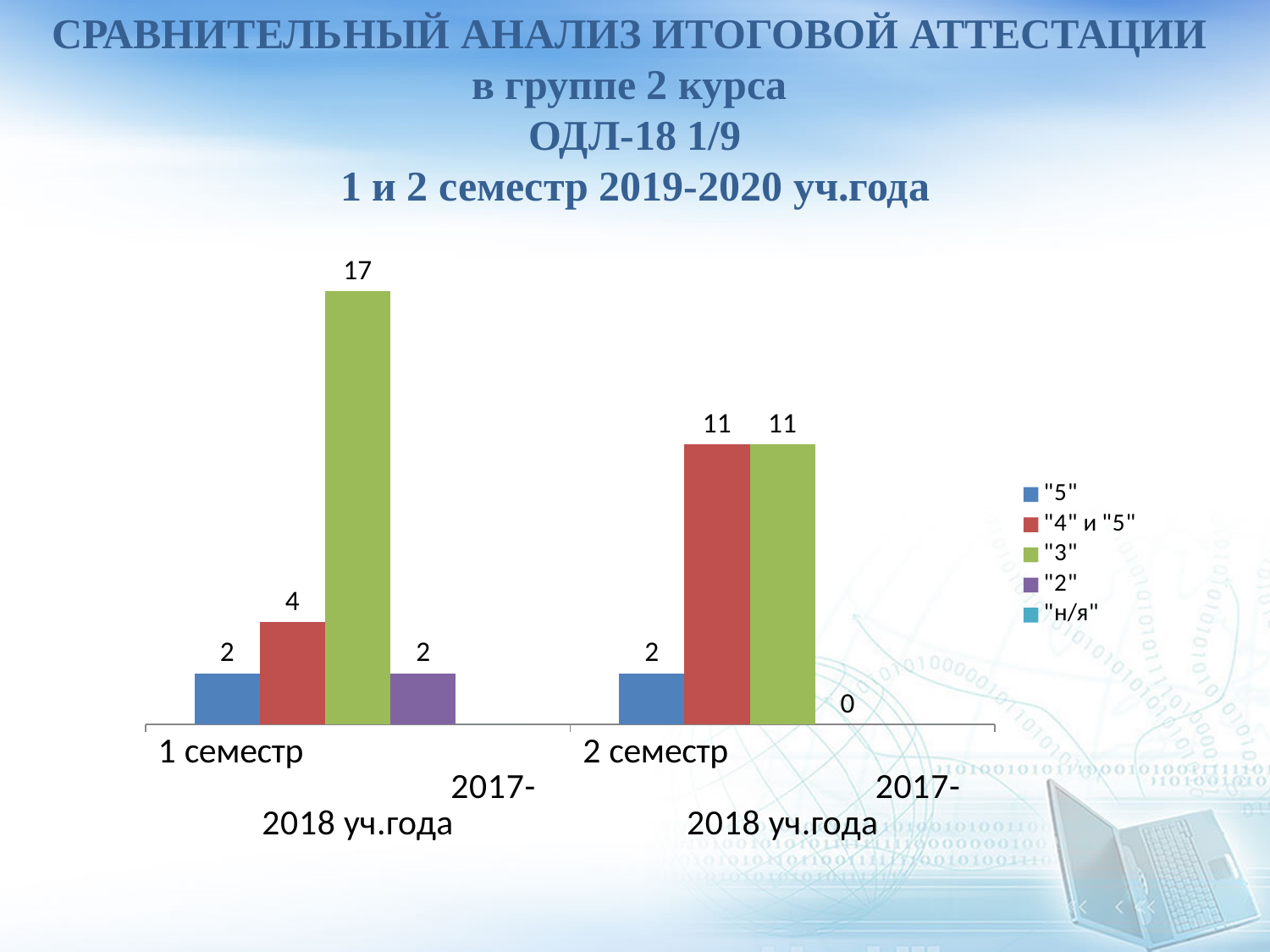
What is the value for "2" in 2 семестр 2017-2018 уч.года? 0 How many series does the legend list? 5 Which series has the highest value in 1 семестр 2017-2018 уч.года? "3" What is the value for "4" и "5" in 2 семестр 2017-2018 уч.года? 11 Which is larger: the "4" и "5" value in 1 семестр or in 2 семестр 2017-2018 уч.года? 2 семестр How many categories are shown on the x axis? 2 What kind of chart is shown on the slide? Bar chart What is the value for "5" in 1 семестр 2017-2018 уч.года? 2 What is the difference between the "4" и "5" values for 2 семестр and 1 семестр 2017-2018 уч.года? 7 What is the value for "3" in 1 семестр 2017-2018 уч.года? 17 What colour represents the "3" series in the legend? Green What is the difference between the "3" values for 1 семестр and 2 семестр 2017-2018 уч.года? 6